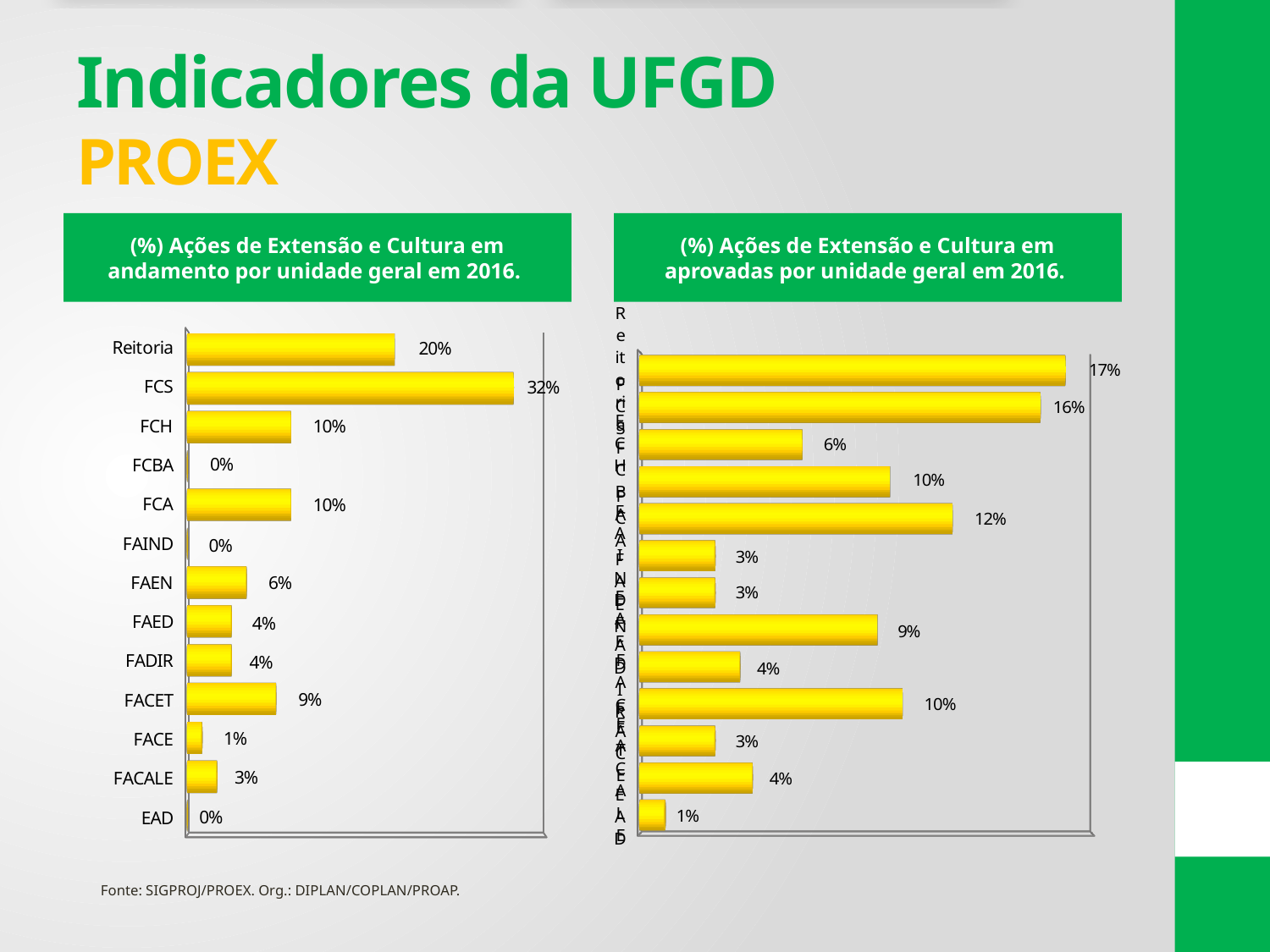
In the chart titled "(%) Ações de Extensão e Cultura em andamento por unidade geral em 2016", what is the difference between the values for FCH and FACALE? 7% In the chart titled "(%) Ações de Extensão e Cultura em andamento por unidade geral em 2016", how many units are shown? 13 In the chart titled "(%) Ações de Extensão e Cultura em aprovadas por unidade geral em 2016", what is the highest value shown on any bar? 17% In the chart titled "(%) Ações de Extensão e Cultura em aprovadas por unidade geral em 2016", how many bars are shown? 13 In the chart titled "(%) Ações de Extensão e Cultura em andamento por unidade geral em 2016", what is the value for FACE? 1% In the chart titled "(%) Ações de Extensão e Cultura em andamento por unidade geral em 2016", what is the value for Reitoria? 20% In the chart titled "(%) Ações de Extensão e Cultura em andamento por unidade geral em 2016", which is larger, the value for FAEN or the value for FAED? FAEN What kind of chart is the chart on the left of the slide? Bar chart In the chart titled "(%) Ações de Extensão e Cultura em andamento por unidade geral em 2016", what is the difference between the values for FCS and Reitoria? 12% In the chart titled "(%) Ações de Extensão e Cultura em andamento por unidade geral em 2016", what is the value for FACET? 9% In the chart titled "(%) Ações de Extensão e Cultura em andamento por unidade geral em 2016", what is the value for FCS? 32% In the chart titled "(%) Ações de Extensão e Cultura em andamento por unidade geral em 2016", which unit has the highest value? FCS